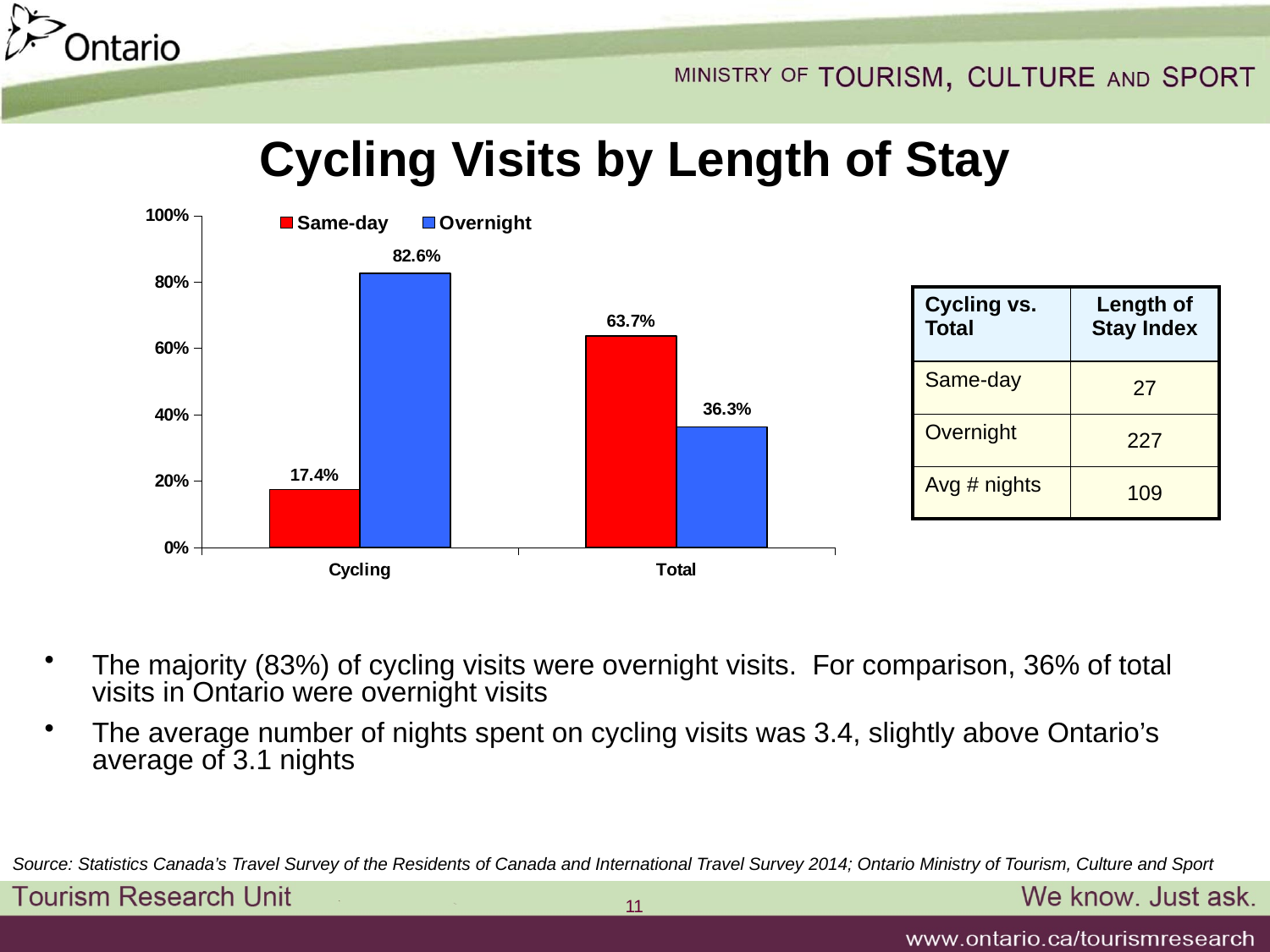
Which category has the lowest Same-day value? Cycling Is the Overnight value for Cycling greater or less than 80%? greater What is the Overnight value for Cycling? 82.6% Which category has the highest Overnight value? Cycling What is the Same-day value for Cycling? 17.4% What is the Same-day value for Total? 63.7% What kind of chart is shown on the slide? Bar chart What is the difference between the Overnight and Same-day values for Cycling? 65.2% Which is larger for Total: Same-day or Overnight? Same-day How many series does the legend list? 2 How many categories are shown on the x axis? 2 What is the Overnight value for Total? 36.3%